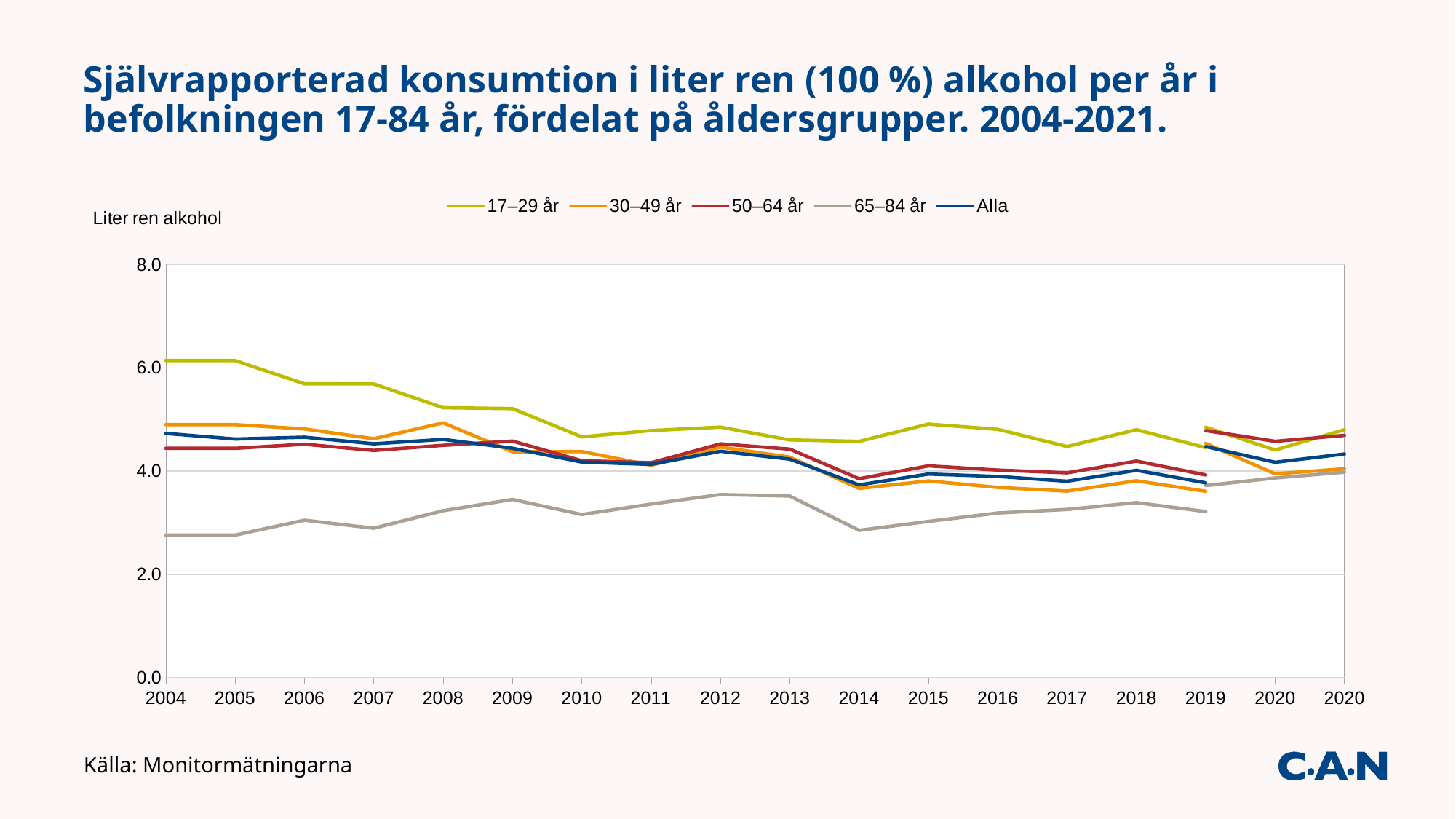
Is the value for 17–29 år in 2004 greater or less than 4.0? greater Is the value for 65–84 år in 2004 greater or less than 4.0? less Does the 65–84 år line rise or fall from 2004 to 2018? rise Does the 17–29 år line rise or fall from 2004 to 2014? fall Which age group has the lowest value in 2004? 65–84 år What source is cited below the chart? Monitormätningarna Is the value for 65–84 år in 2014 greater or less than 4.0? less What is the label on the vertical axis? Liter ren alkohol Which is larger in 2010, the value for 17–29 år or the value for 65–84 år? 17–29 år Which age group has the highest value in 2004? 17–29 år What kind of chart is shown on the slide? Line chart How many series does the legend list? 5